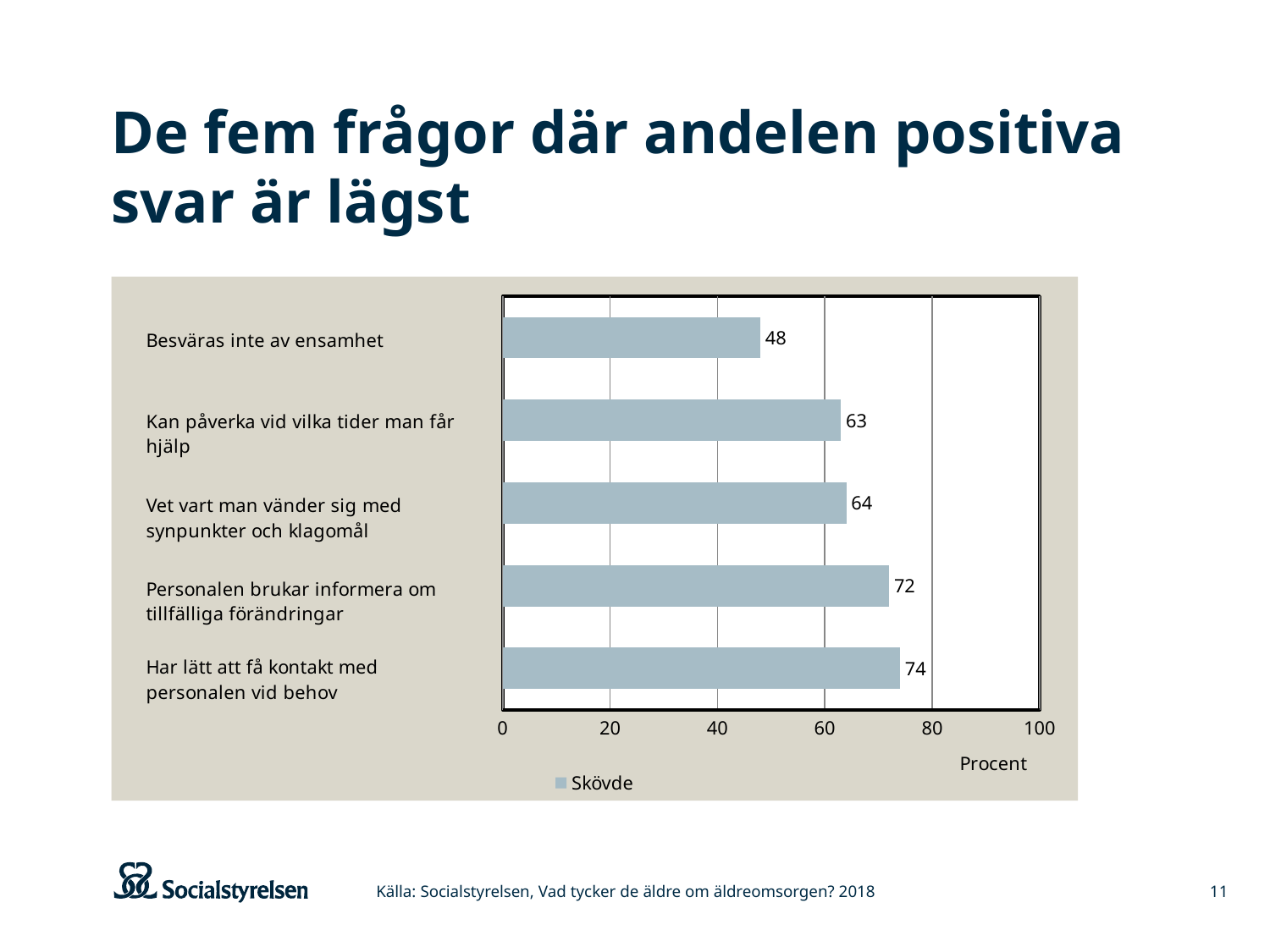
Which category has the highest value? Har lätt att få kontakt med personalen vid behov Which category has the lowest value? Besväras inte av ensamhet Is the value for "Vet vart man vänder sig med synpunkter och klagomål" greater or less than 80? less What kind of chart is shown on the slide? bar chart What is the difference between the values for "Har lätt att få kontakt med personalen vid behov" and "Besväras inte av ensamhet"? 26 How many categories are shown in the chart? 5 What is the value for "Personalen brukar informera om tillfälliga förändringar"? 72 How many series does the legend list? 1 What is the value for "Besväras inte av ensamhet"? 48 What series name is shown in the legend? Skövde Which is larger: the value for "Kan påverka vid vilka tider man får hjälp" or the value for "Personalen brukar informera om tillfälliga förändringar"? Personalen brukar informera om tillfälliga förändringar What is the value for "Har lätt att få kontakt med personalen vid behov"? 74